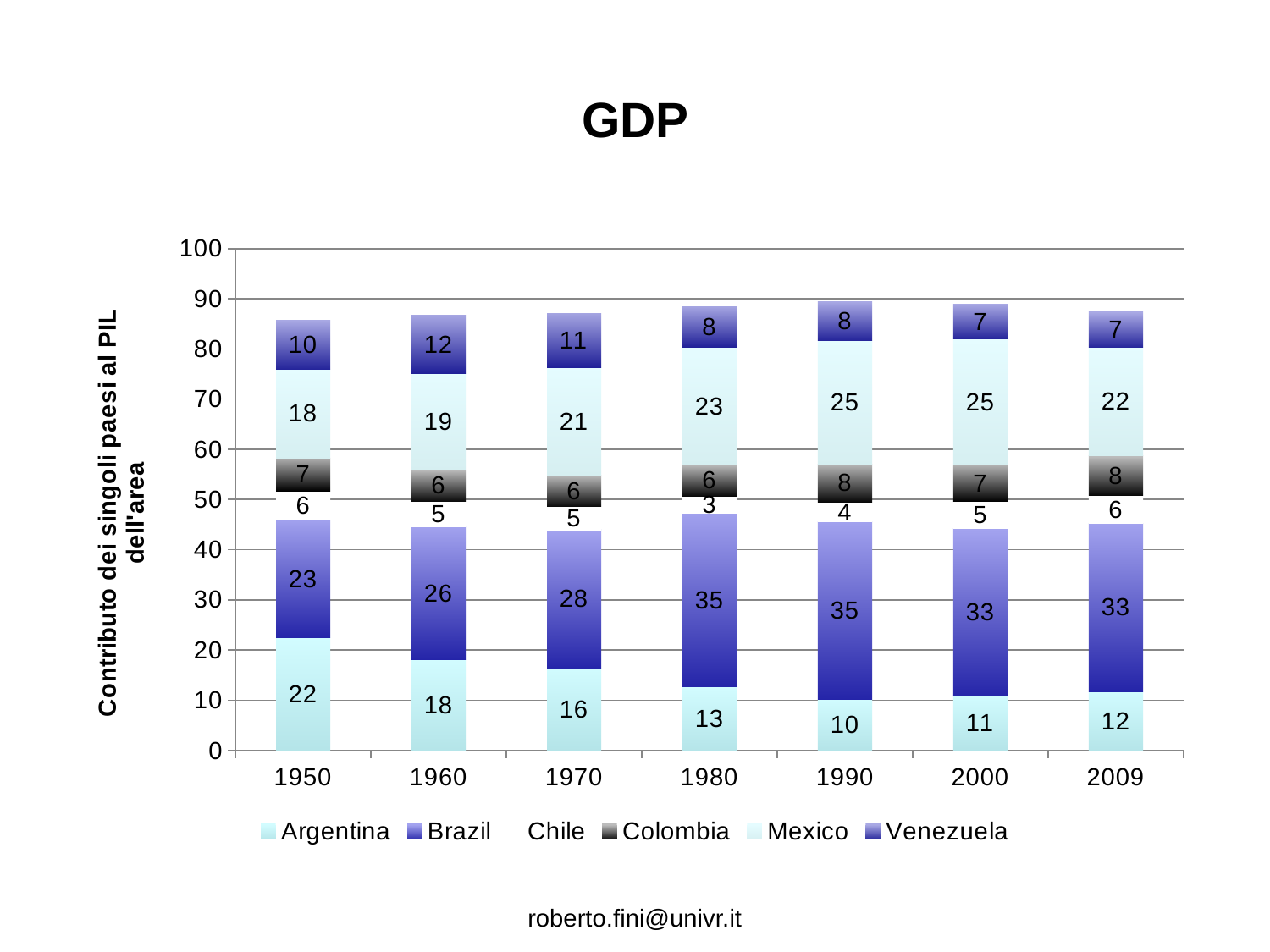
What is the value for Colombia in 1990? 8 In which year is the value for Venezuela highest? 1960 What is the value for Argentina in 1950? 22 What is the value for Brazil in 1980? 35 How many years are shown on the x axis? 7 In which year is the value for Argentina highest? 1950 What is the value for Mexico in 2009? 22 Which is larger in 1990, the value for Mexico or the value for Argentina? Mexico What is the difference between the Brazil values in 2009 and 1950? 10 What kind of chart is shown on the slide? Stacked bar chart How many series does the legend list? 6 In which year is the value for Argentina lowest? 1990